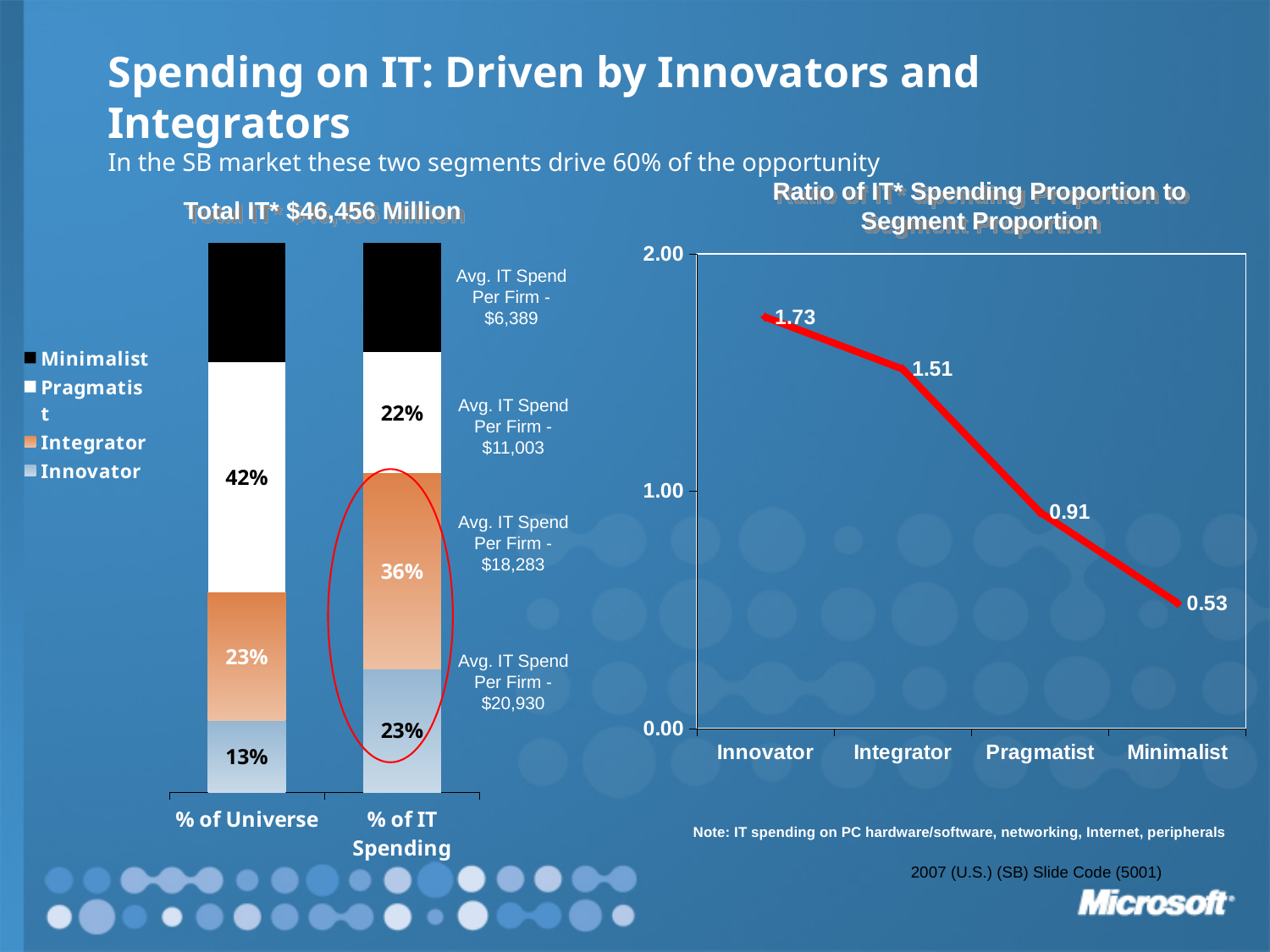
In the 'Total IT* $46,456 Million' chart, what percentage of IT spending is Integrator? 36% In the 'Ratio of IT* Spending Proportion to Segment Proportion' chart, what is the ratio for Innovator? 1.73 In the 'Total IT* $46,456 Million' chart, is the Pragmatist share larger in '% of Universe' or '% of IT Spending'? % of Universe What kind of chart is the 'Ratio of IT* Spending Proportion to Segment Proportion' chart? line chart In the 'Total IT* $46,456 Million' chart, what percentage of the universe is Innovator? 13% In the 'Ratio of IT* Spending Proportion to Segment Proportion' chart, do the values rise or fall from Innovator to Minimalist? fall In the 'Ratio of IT* Spending Proportion to Segment Proportion' chart, what is the ratio for Minimalist? 0.53 In the 'Ratio of IT* Spending Proportion to Segment Proportion' chart, which segment has the lowest ratio? Minimalist How many segments does the legend of the 'Total IT* $46,456 Million' chart list? 4 In the 'Ratio of IT* Spending Proportion to Segment Proportion' chart, what is the difference between the Innovator and Integrator ratios? 0.22 In the 'Ratio of IT* Spending Proportion to Segment Proportion' chart, is the value for Pragmatist greater or less than 1.00? less In the 'Ratio of IT* Spending Proportion to Segment Proportion' chart, which segment has the highest ratio? Innovator